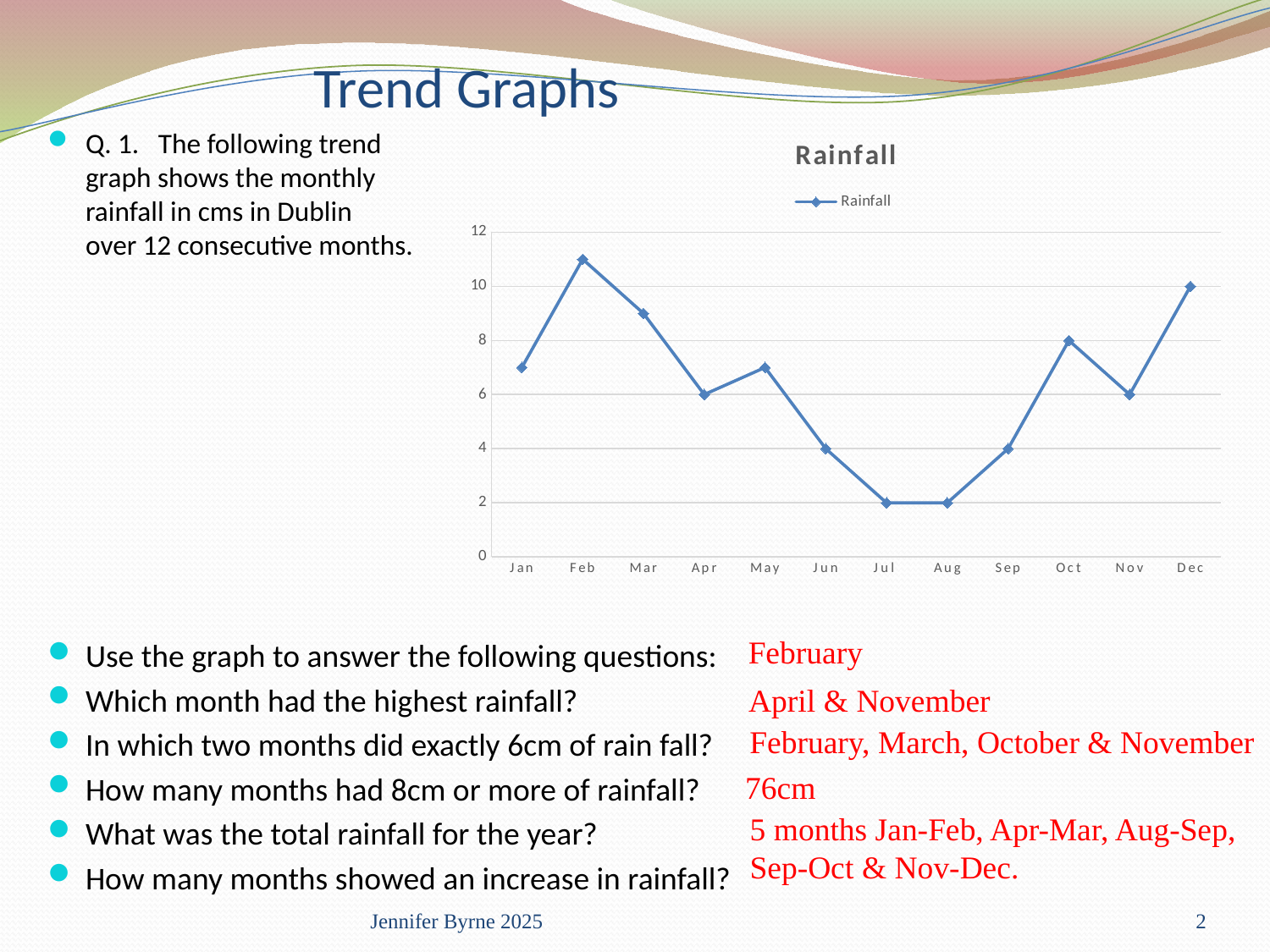
What is the title of the chart? Rainfall Is the rainfall value for Feb greater or less than 10? greater Which has the larger rainfall value, Oct or Nov? Oct What is the rainfall value for Dec? 10 Does the rainfall value rise or fall from Feb to Apr? fall How many months are plotted on the x axis? 12 Which month has the highest rainfall value? Feb What kind of chart is shown on the slide? line chart What is the difference between the rainfall values for Dec and Oct? 2 How many series does the legend list? 1 What is the rainfall value for Oct? 8 What is the rainfall value for Jul? 2